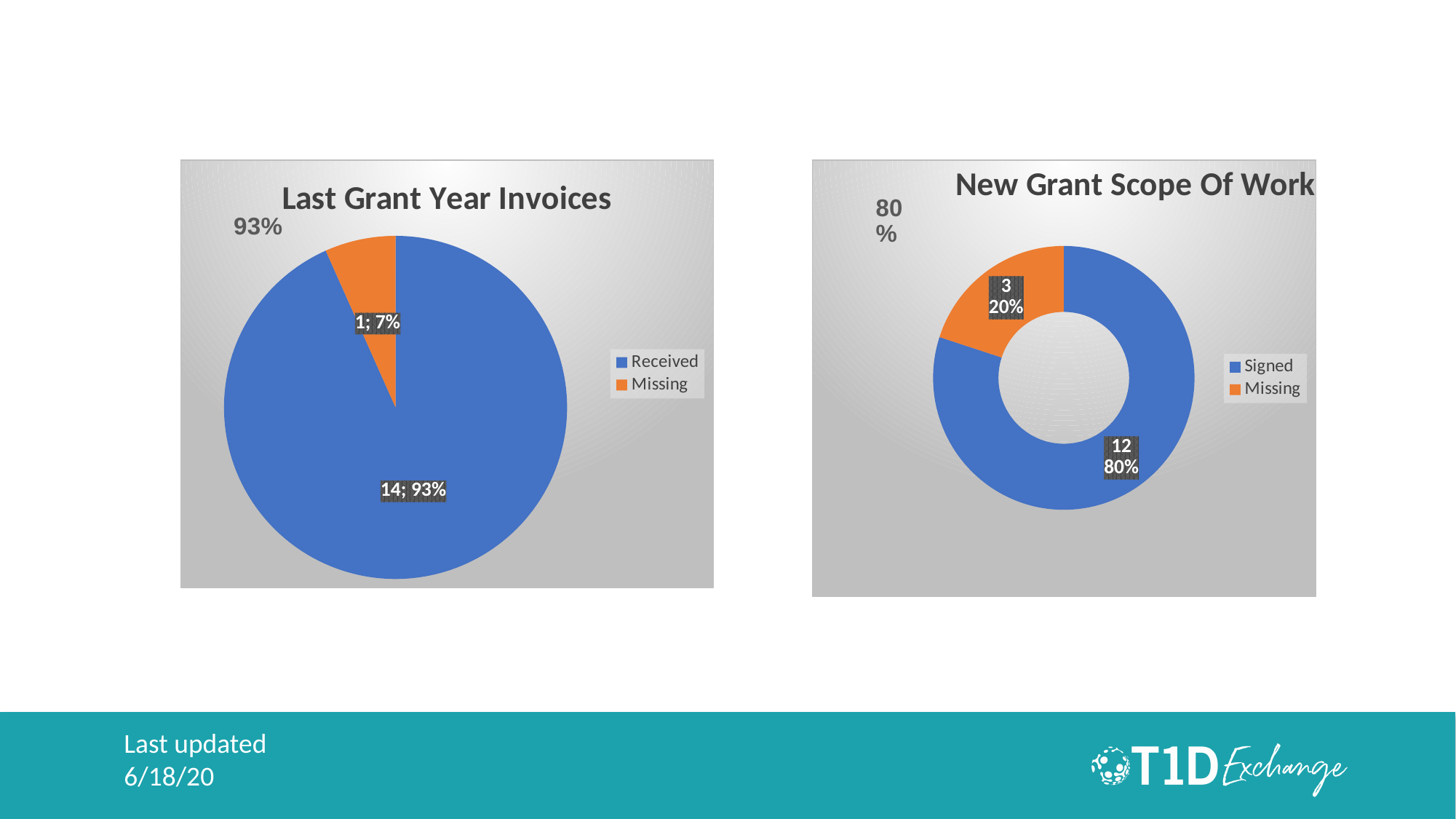
In the 'Last Grant Year Invoices' chart, what percentage of invoices are missing? 7% How many series does the legend of the 'New Grant Scope Of Work' chart list? 2 In the 'New Grant Scope Of Work' chart, which category is the smallest? Missing In the 'New Grant Scope Of Work' chart, what percentage is 'Missing'? 20% In the 'New Grant Scope Of Work' chart, how many scopes of work are signed? 12 In the 'Last Grant Year Invoices' chart, what share of the pie is 'Received'? 93% In the 'Last Grant Year Invoices' chart, which category is the largest? Received In the 'Last Grant Year Invoices' chart, how many invoices were received? 14 In the 'New Grant Scope Of Work' chart, what colour represents 'Signed'? Blue In the 'New Grant Scope Of Work' chart, what is the difference between the number signed and the number missing? 9 What kind of chart is 'Last Grant Year Invoices'? Pie chart In the 'Last Grant Year Invoices' chart, what is the total number of invoices across both categories? 15